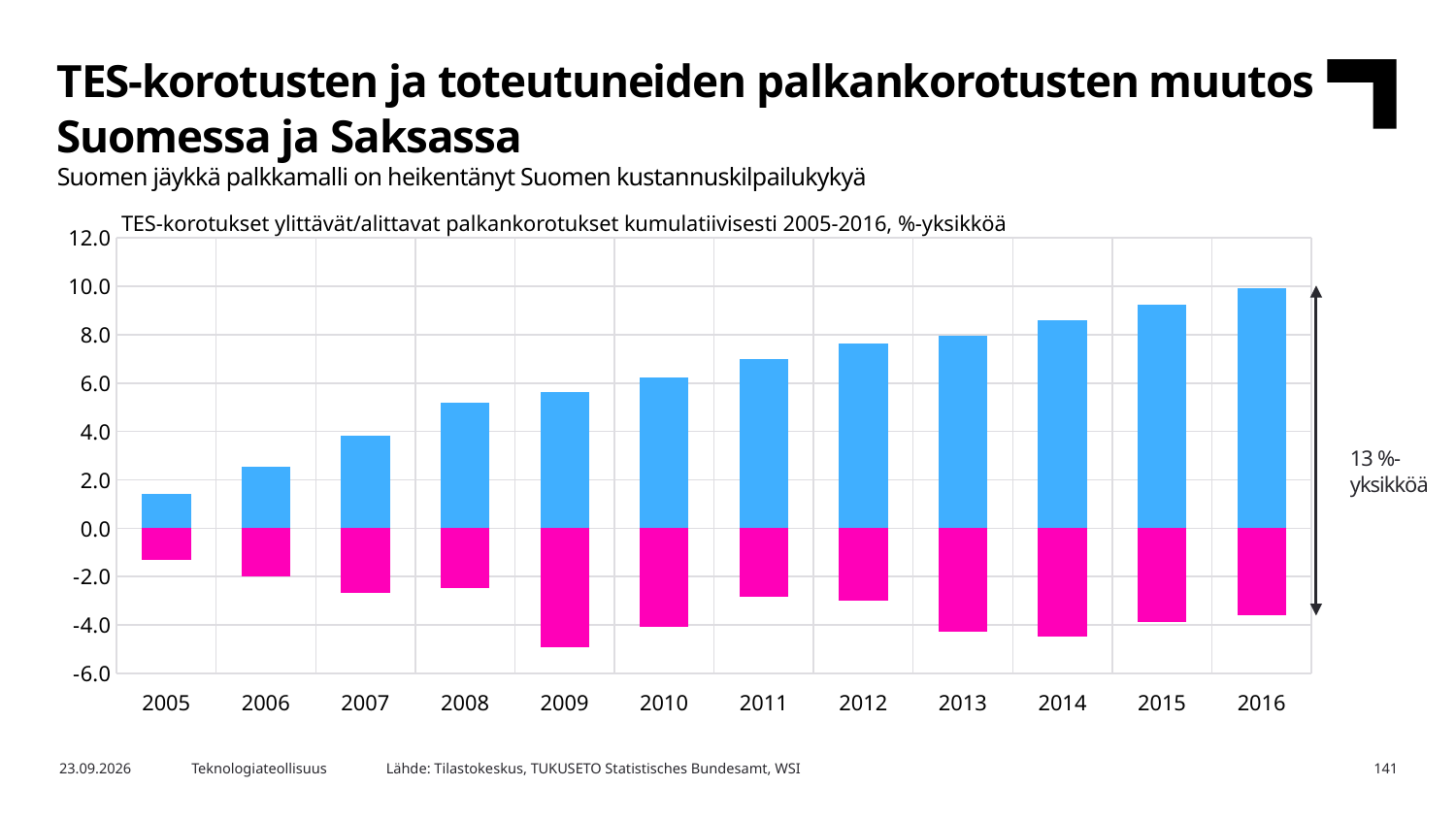
Is the blue bar for 2016 greater or less than 8.0? greater Which year has the longest magenta (negative) bar? 2009 Which year has the shortest blue (positive) bar? 2005 Is the blue bar for 2005 greater or less than 2.0? less Is the magenta bar for 2009 greater or less than -4.0? less What value does the annotation with the arrow on the right of the chart state? 13 %-yksikköä How many years are shown on the x axis of the chart? 12 Which year has the tallest blue (positive) bar? 2016 Which year has the larger blue bar, 2008 or 2014? 2014 Do the blue bars rise or fall from 2005 to 2016? rise What kind of chart is shown on the slide? bar chart